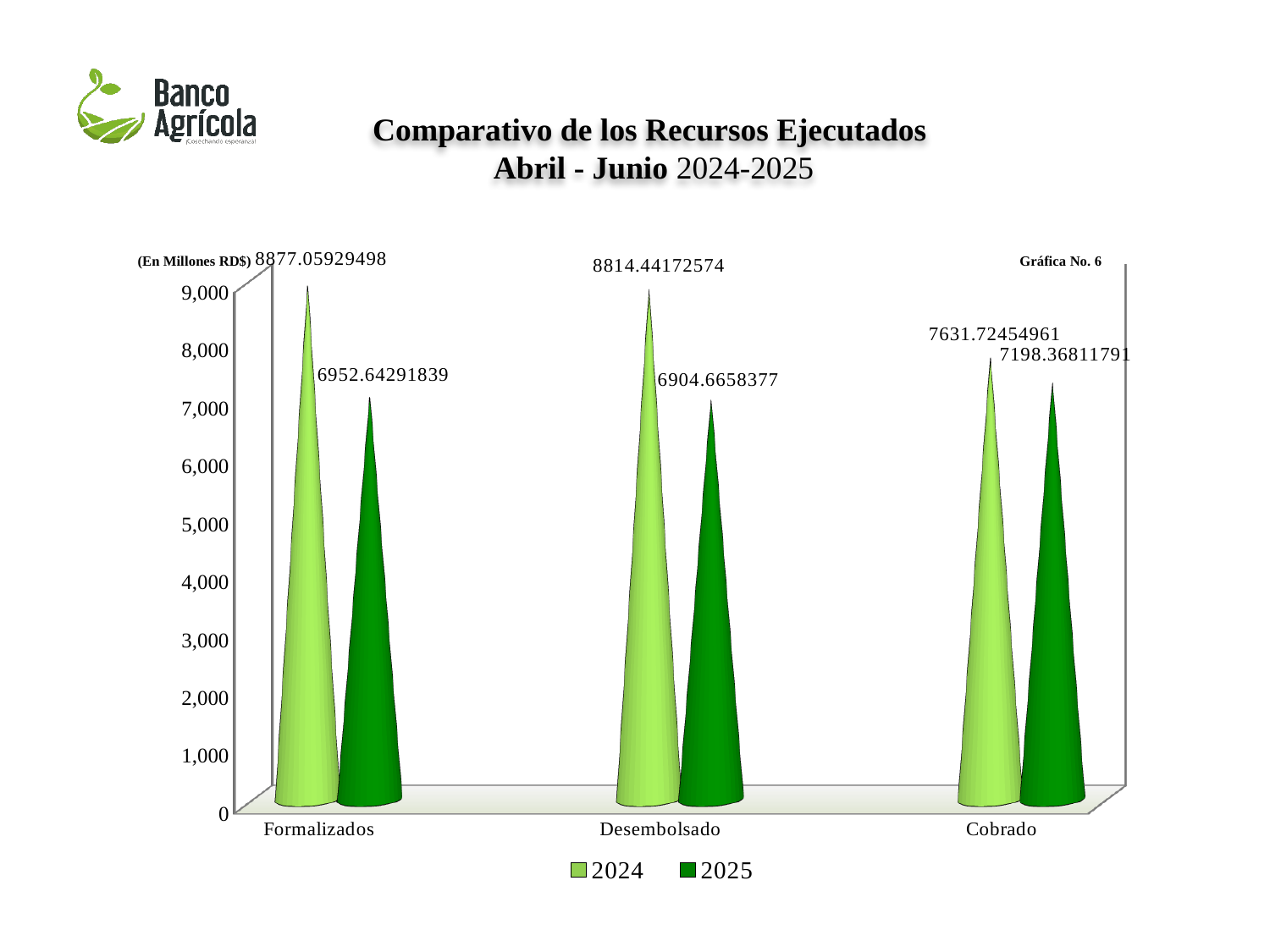
What is the value for Cobrado in the 2024 series? 7631.72454961 Which is larger for Desembolsado, the 2024 value or the 2025 value? 2024 How many categories are shown on the x axis? 3 What unit is stated for the values in the chart? En Millones RD$ What is the value for Cobrado in the 2025 series? 7198.36811791 What is the value for Desembolsado in the 2025 series? 6904.6658377 Which category has the highest value in the 2024 series? Formalizados Which category has the lowest value in the 2024 series? Cobrado Which category has the highest value in the 2025 series? Cobrado What is the value for Formalizados in the 2024 series? 8877.05929498 How many series does the legend list? 2 What is the difference between the 2024 and 2025 values for Cobrado? 433.3564317